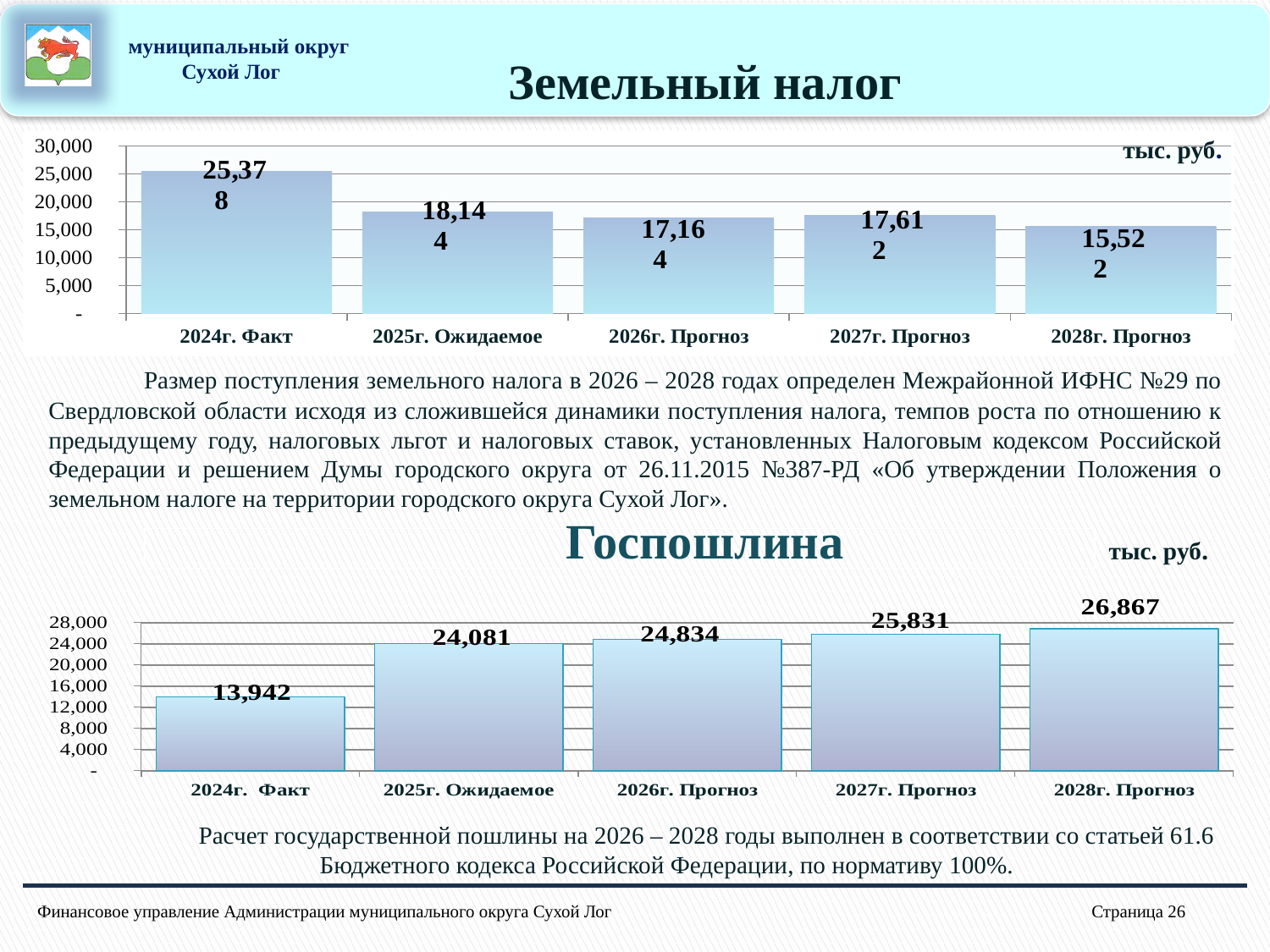
In the Земельный налог chart, what is the value for 2024г. Факт? 25,378 In the Госпошлина chart, what is the value for 2024г. Факт? 13,942 In the Госпошлина chart, what is the value for 2027г. Прогноз? 25,831 In the Земельный налог chart, what is the difference between the values for 2024г. Факт and 2025г. Ожидаемое? 7,234 What kind of chart is the Госпошлина chart? bar chart In the Госпошлина chart, which category has the highest value? 2028г. Прогноз In the Земельный налог chart, which category has the highest value? 2024г. Факт In the Земельный налог chart, how many categories are shown on the x axis? 5 In the Земельный налог chart, what is the value for 2028г. Прогноз? 15,522 In the Госпошлина chart, what is the difference between the values for 2028г. Прогноз and 2024г. Факт? 12,925 In the Госпошлина chart, do the values rise or fall from 2024г. Факт to 2028г. Прогноз? rise In the Земельный налог chart, which category has the lowest value? 2028г. Прогноз